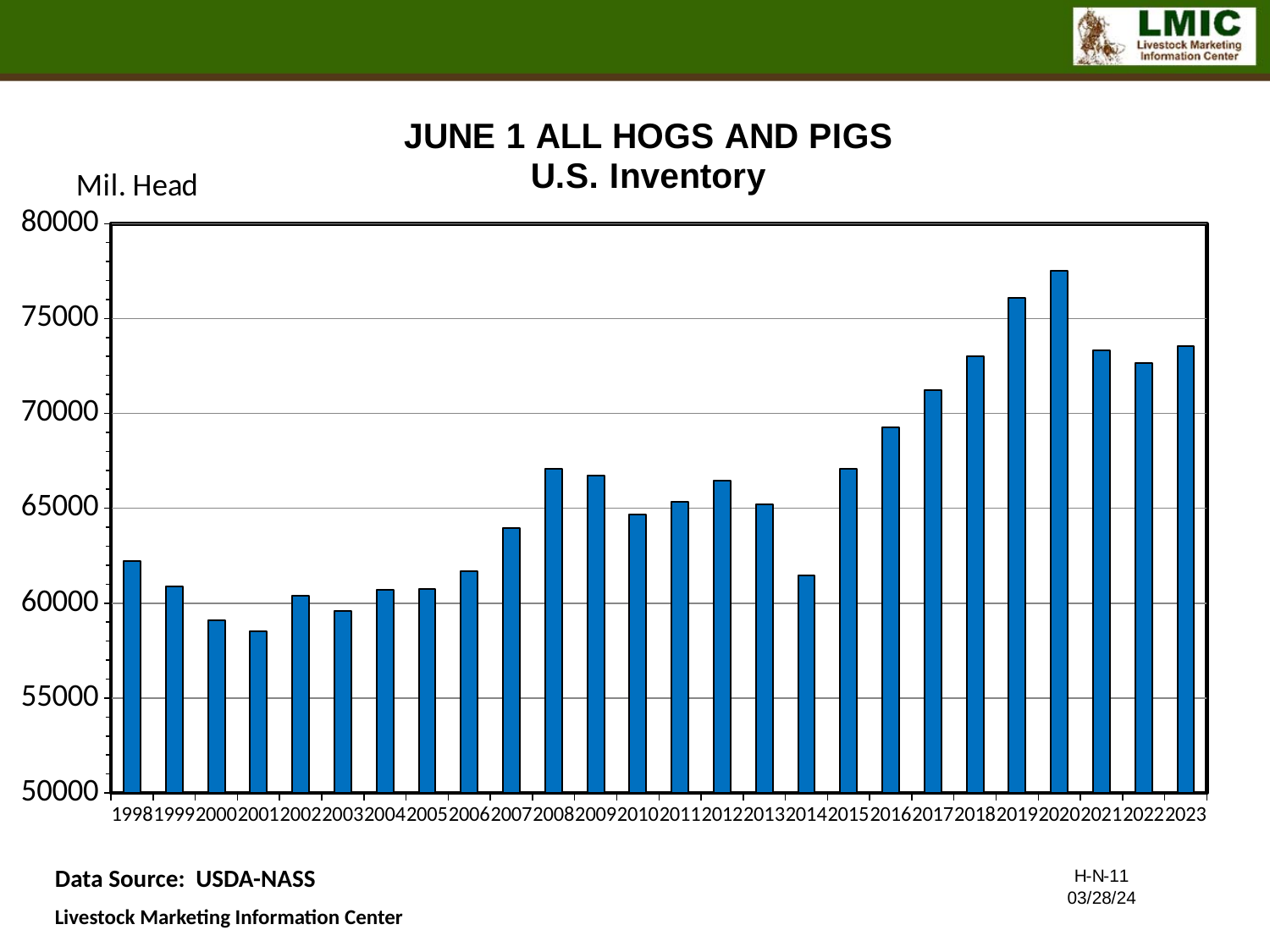
Which year has the highest June 1 hogs and pigs inventory? 2020 Is the value for 2014 greater or less than 65000? less What kind of chart is shown on the slide? bar chart Do the values rise or fall from 2014 to 2020? rise Is the value for 2017 greater or less than 70000? greater Which year has the lowest June 1 hogs and pigs inventory? 2001 What unit is shown on the y axis label of the chart? Mil. Head Which year has the larger inventory, 2018 or 2019? 2019 Is the value for 2001 greater or less than 60000? less Which year has the larger inventory, 2014 or 2015? 2015 How many years are plotted on the x axis of the chart? 26